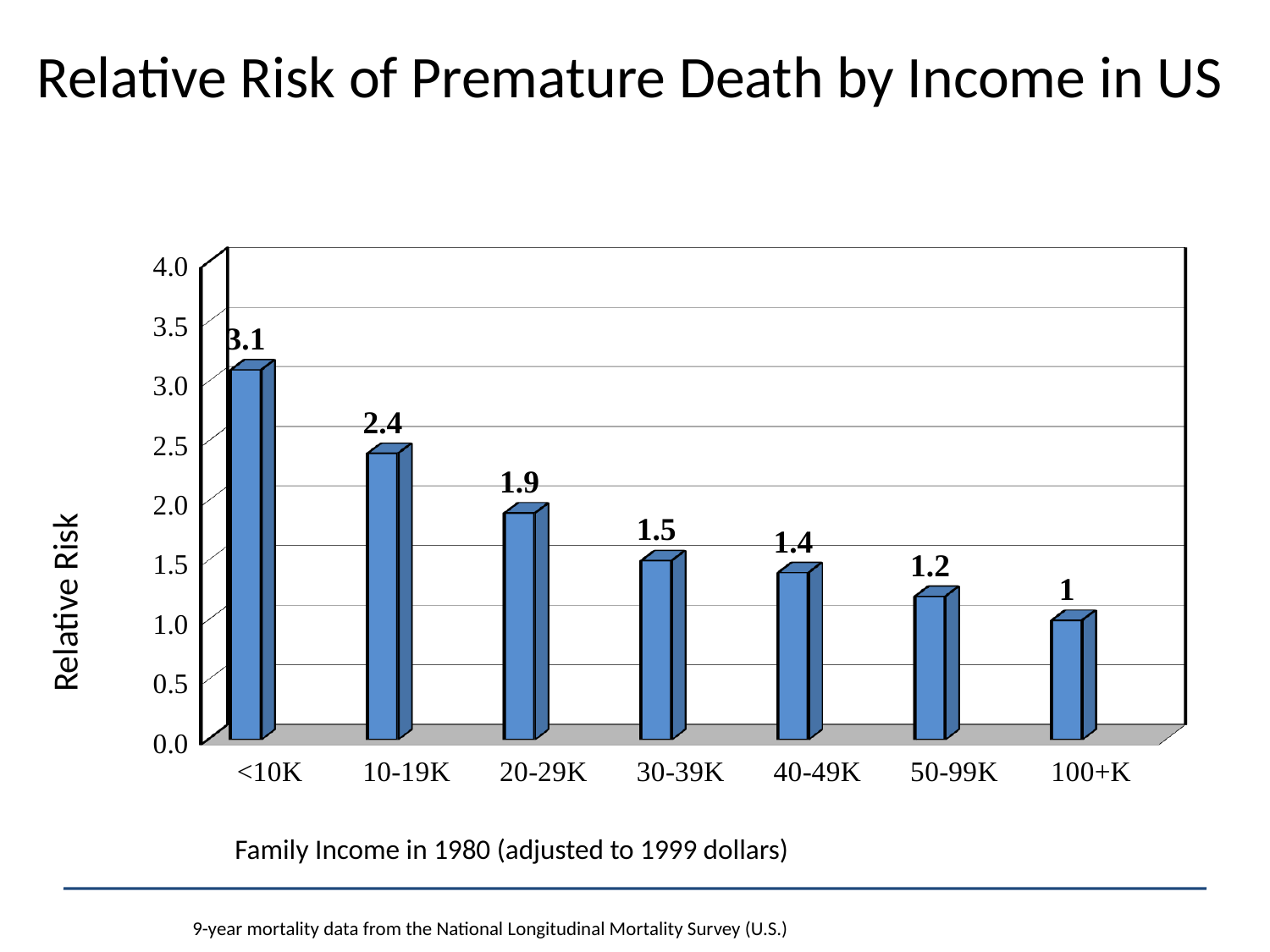
What is the relative risk for the <10K income group? 3.1 What is the difference in relative risk between the 30-39K and 100+K groups? 0.5 Do the relative risk values rise or fall as income increases along the x axis? fall What is the relative risk for the 20-29K income group? 1.9 What is the relative risk for the 50-99K income group? 1.2 Is the relative risk for the 20-29K group greater or less than 2.0? less Which has a higher relative risk, the 10-19K group or the 40-49K group? 10-19K What is the difference in relative risk between the <10K and 10-19K groups? 0.7 Which income group has the highest relative risk? <10K What kind of chart is shown on the slide? bar chart How many income groups are shown on the x axis? 7 Which income group has the lowest relative risk? 100+K